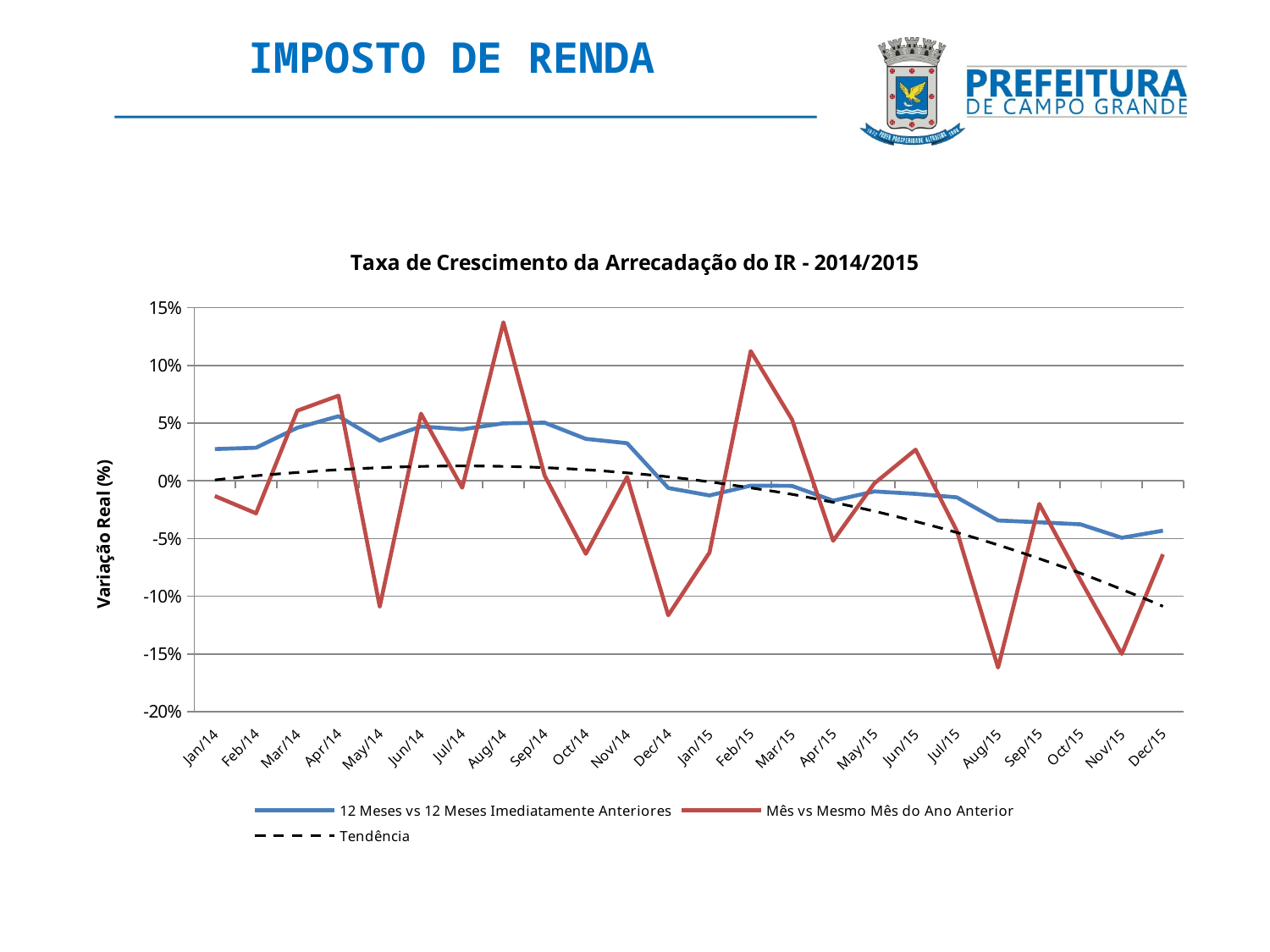
In Aug/15, which series has the larger value: '12 Meses vs 12 Meses Imediatamente Anteriores' or 'Mês vs Mesmo Mês do Ano Anterior'? 12 Meses vs 12 Meses Imediatamente Anteriores Does the 'Tendência' line rise or fall from Jan/14 to Dec/15? It falls Is the value of '12 Meses vs 12 Meses Imediatamente Anteriores' in Dec/15 greater or less than 0%? less Is the value of 'Mês vs Mesmo Mês do Ano Anterior' in Dec/14 greater or less than -10%? less In which month does the 'Mês vs Mesmo Mês do Ano Anterior' series reach its highest value? Aug/14 Is the value of 'Mês vs Mesmo Mês do Ano Anterior' in Aug/14 greater or less than 10%? greater How many months are plotted along the x axis? 24 How many series does the legend list? 3 What is the title of the chart? Taxa de Crescimento da Arrecadação do IR - 2014/2015 Which is larger for 'Mês vs Mesmo Mês do Ano Anterior': the value in Aug/14 or the value in Feb/15? Aug/14 What kind of chart is shown on the slide? Line chart